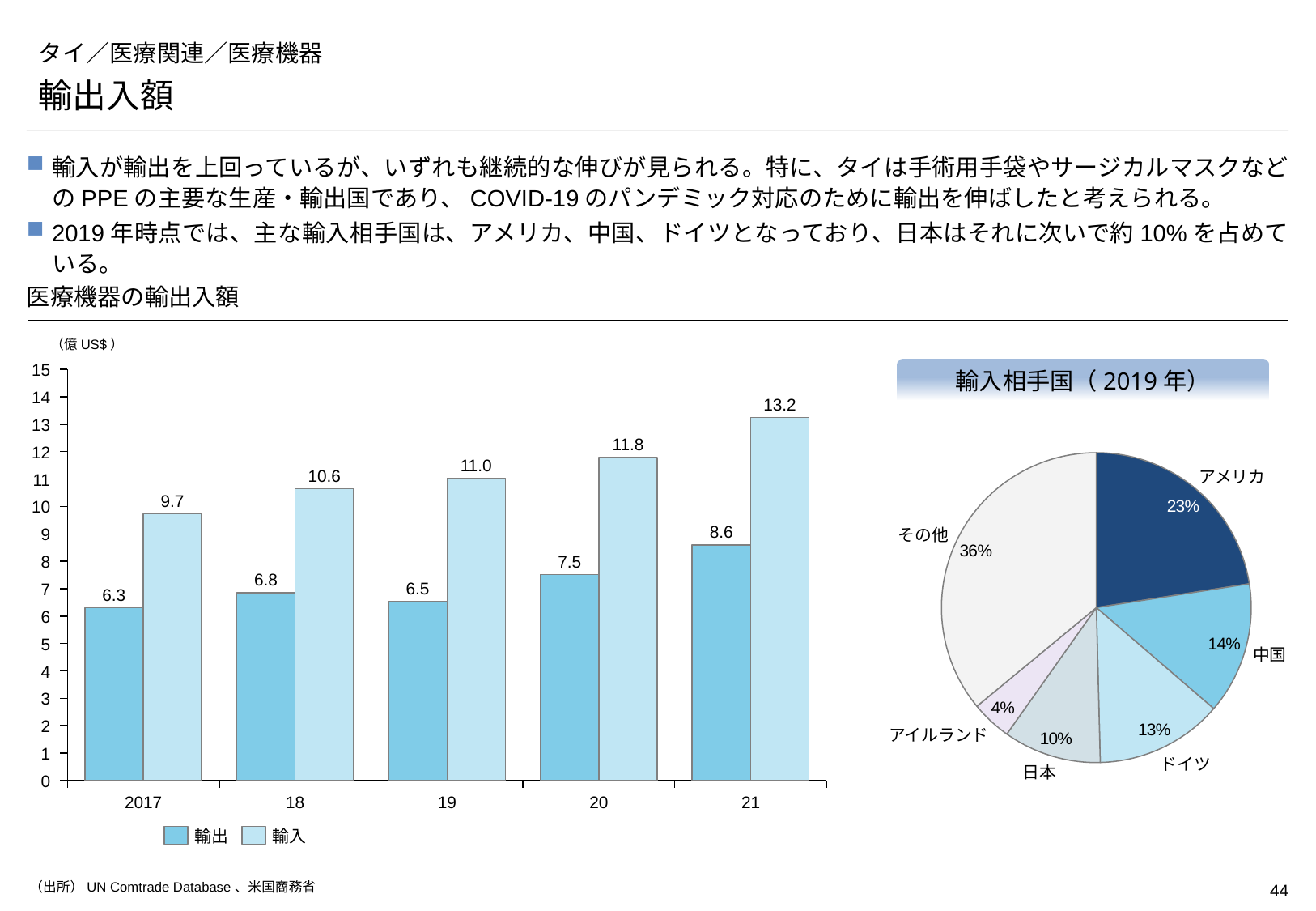
What type of chart is 輸入相手国（2019年）? pie chart In the bar chart 医療機器の輸出入額, which year has the lowest 輸出 value? 2017 In the bar chart 医療機器の輸出入額, which year has the highest 輸入 value? 21 In the bar chart 医療機器の輸出入額, what is the value of 輸入 for 2017? 9.7 In the pie chart 輸入相手国（2019年）, which named country has the largest share? アメリカ In the pie chart 輸入相手国（2019年）, what share does 中国 have? 14% In the bar chart 医療機器の輸出入額, how many series does the legend list? 2 In the bar chart 医療機器の輸出入額, what is the difference between 輸入 and 輸出 in 20? 4.3 In the bar chart 医療機器の輸出入額, which is larger in 19: 輸出 or 輸入? 輸入 In the bar chart 医療機器の輸出入額, what is the value of 輸出 for 21? 8.6 In the bar chart 医療機器の輸出入額, does the 輸入 series rise or fall from 2017 to 21? rise In the bar chart 医療機器の輸出入額, how many years are shown on the x axis? 5